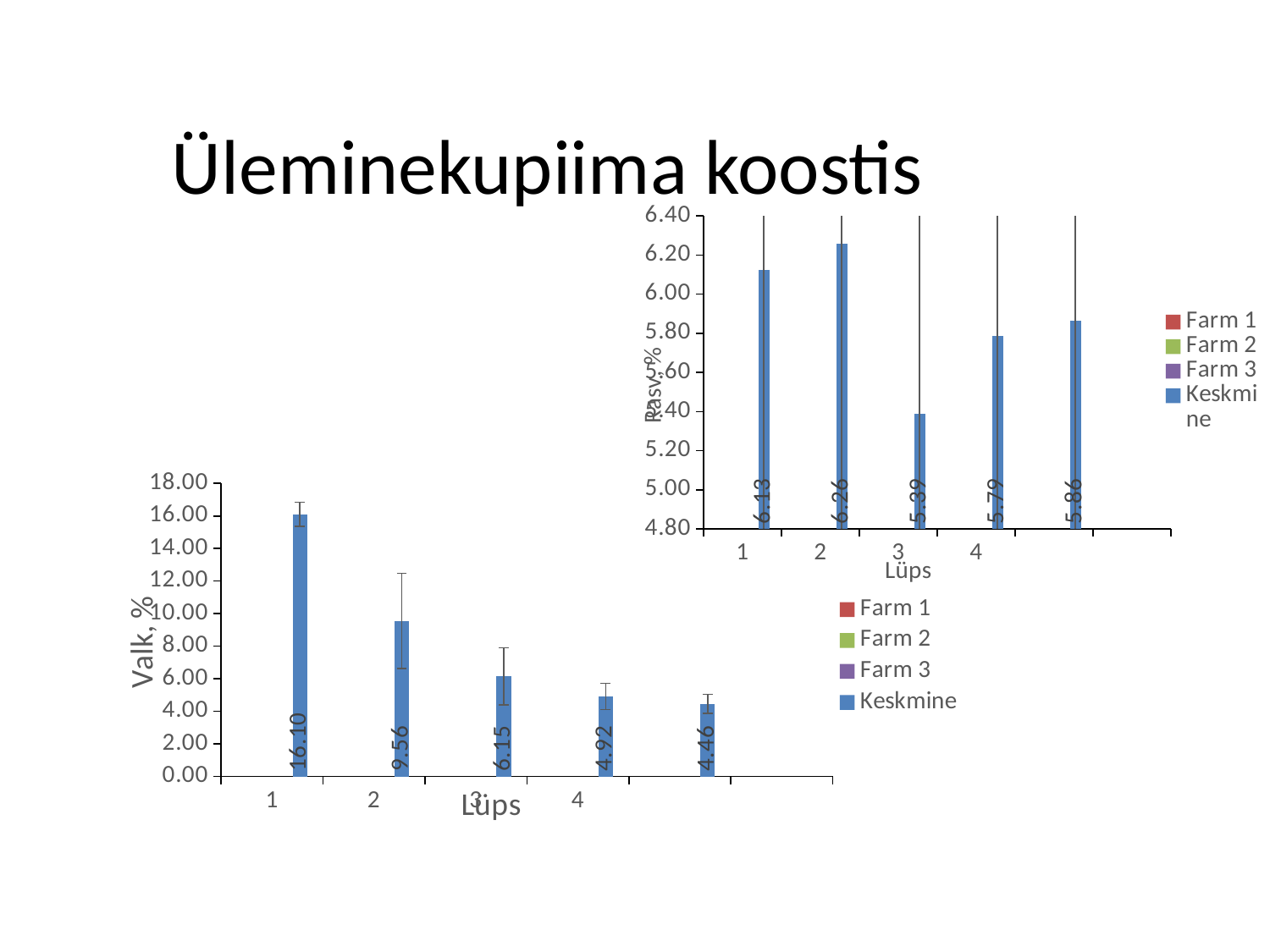
On the Valk, % chart, what is the difference between the values for Lüps 1 and Lüps 2? 6.54 How many bars are plotted on the Valk, % chart? 5 On the Rasv, % chart, which Lüps has the lowest value? 3 On the Valk, % chart, is the value for Lüps 3 greater or less than 8.00? less On the Rasv, % chart, what is the value for Lüps 2? 6.26 On the Rasv, % chart, what is the value for Lüps 3? 5.39 On the Valk, % chart, which Lüps has the highest value? 1 On the Rasv, % chart, which is larger, the value for Lüps 1 or Lüps 4? Lüps 1 On the Valk, % chart, what is the value for Lüps 2? 9.56 How many series does the legend of the Rasv, % chart list? 4 On the Valk, % chart, what is the value for Lüps 1? 16.10 What kind of chart is the Valk, % chart? bar chart